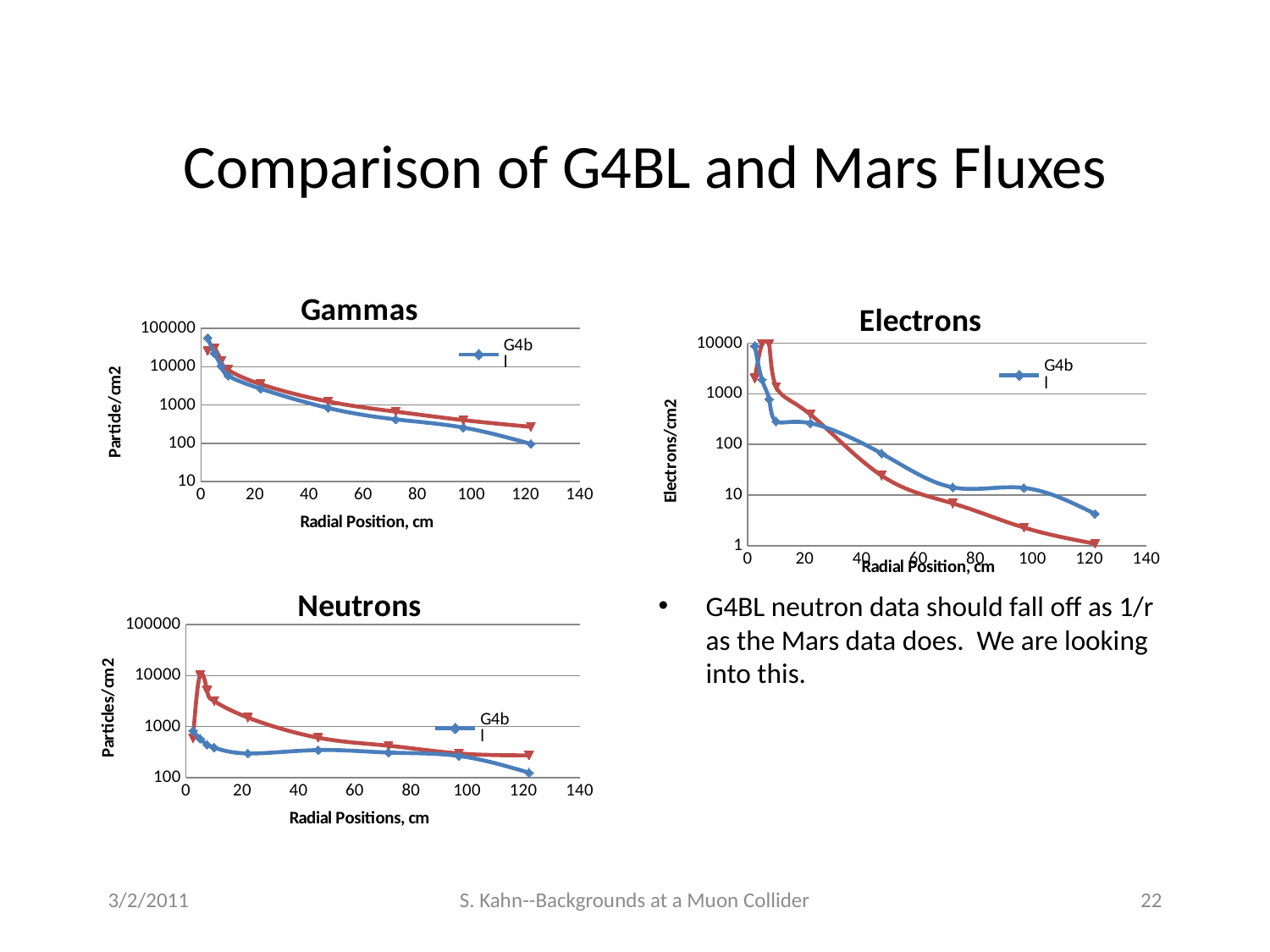
In the Gammas chart, do the values rise or fall as radial position increases? fall In the Gammas chart, at a radial position of 120 cm, which series has the larger value, the red series or the blue G4bl series? the red series How many charts are shown on the slide? 3 In the Neutrons chart, is the value of the red series at a radial position of 20 cm greater or less than 1000? greater What is the y-axis label of the Electrons chart? Electrons/cm2 In the Electrons chart, at a radial position of 120 cm, which series has the larger value, the red series or the blue G4bl series? the blue G4bl series In the Gammas chart, is the value of the blue G4bl series at the smallest radial position greater or less than 10000? greater In the Electrons chart, is the value of the blue G4bl series at a radial position of 120 cm greater or less than 10? less In the Electrons chart, do the values generally rise or fall as radial position increases? fall What kind of chart is the Gammas chart? line chart